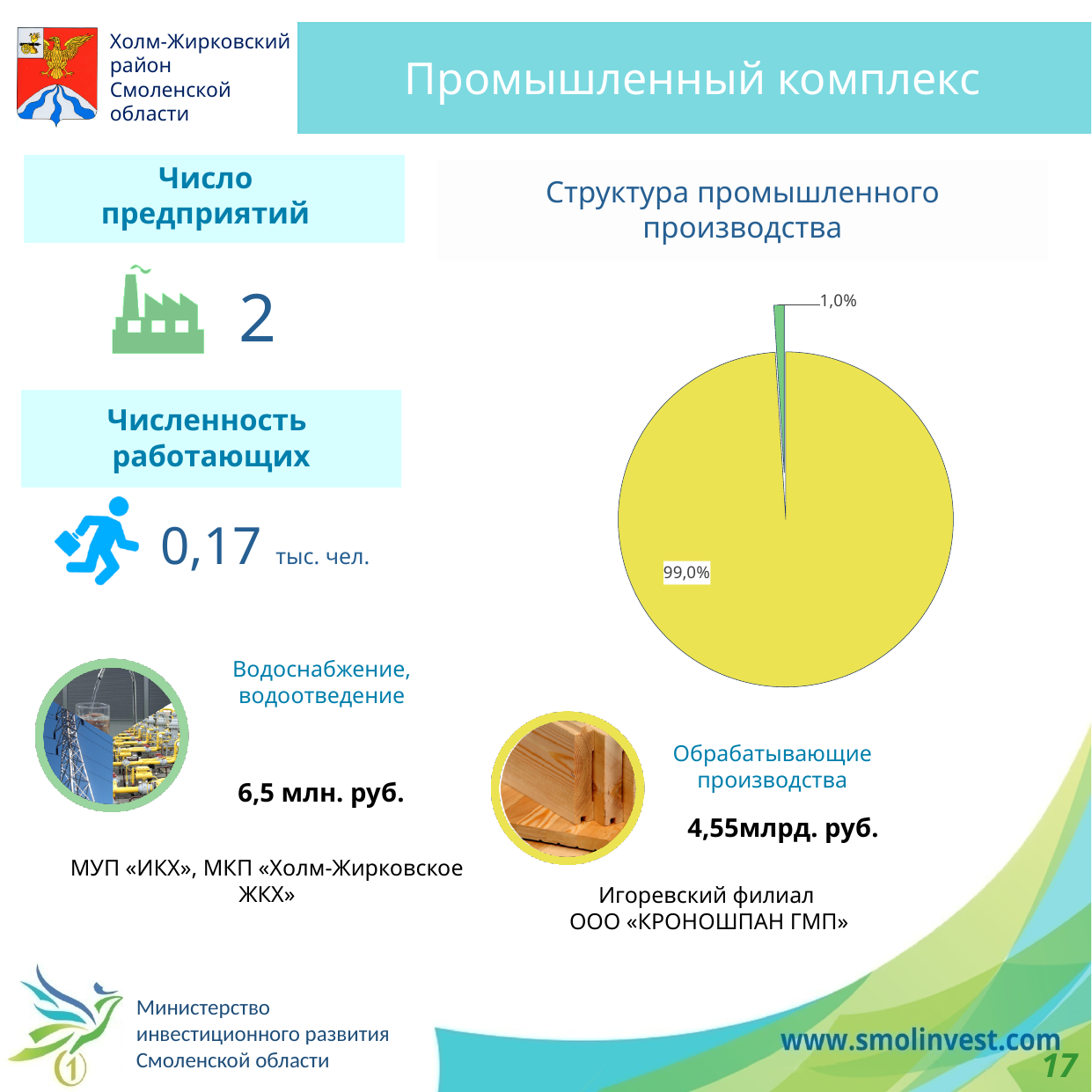
In the pie chart «Структура промышленного производства», which slice is larger, the yellow one or the green one? the yellow one Do the two slices of the pie chart «Структура промышленного производства» add up to 100%? yes What colour is the largest slice of the pie chart «Структура промышленного производства»? yellow In the pie chart «Структура промышленного производства», what share is labelled on the green slice? 1,0% How many slices does the pie chart «Структура промышленного производства» have? 2 What kind of chart is shown under the heading «Структура промышленного производства»? pie chart What is the share of the largest slice in the pie chart «Структура промышленного производства»? 99,0% What is the share of the smallest slice in the pie chart «Структура промышленного производства»? 1,0% Is the share of the yellow slice in the pie chart «Структура промышленного производства» greater or less than 50%? greater In the pie chart «Структура промышленного производства», what is the difference in percentage points between the two slices? 98,0 What is the title of the chart on the right side of the slide? Структура промышленного производства In the pie chart «Структура промышленного производства», what share is labelled on the yellow slice? 99,0%